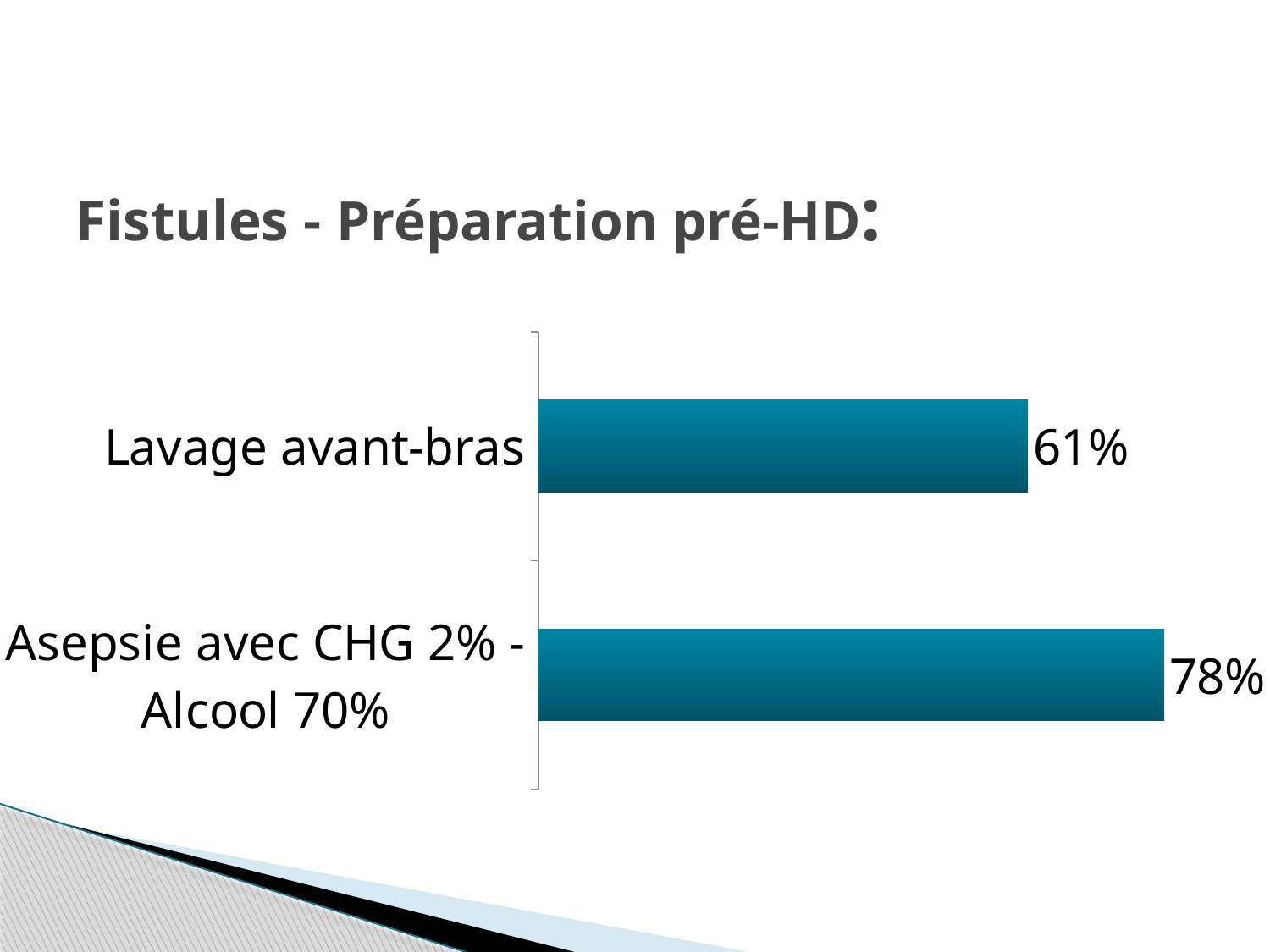
What is the difference between the values for Asepsie avec CHG 2% - Alcool 70% and Lavage avant-bras? 17% What is the value for Lavage avant-bras? 61% Are the bars in the chart horizontal or vertical? Horizontal How many categories are shown in the chart? 2 What is the value for Asepsie avec CHG 2% - Alcool 70%? 78% Which category has the highest value? Asepsie avec CHG 2% - Alcool 70% What is the title of the slide? Fistules - Préparation pré-HD: What kind of chart is shown on the slide? Bar chart Which is larger, the value for Lavage avant-bras or the value for Asepsie avec CHG 2% - Alcool 70%? Asepsie avec CHG 2% - Alcool 70% Which category has the lowest value? Lavage avant-bras